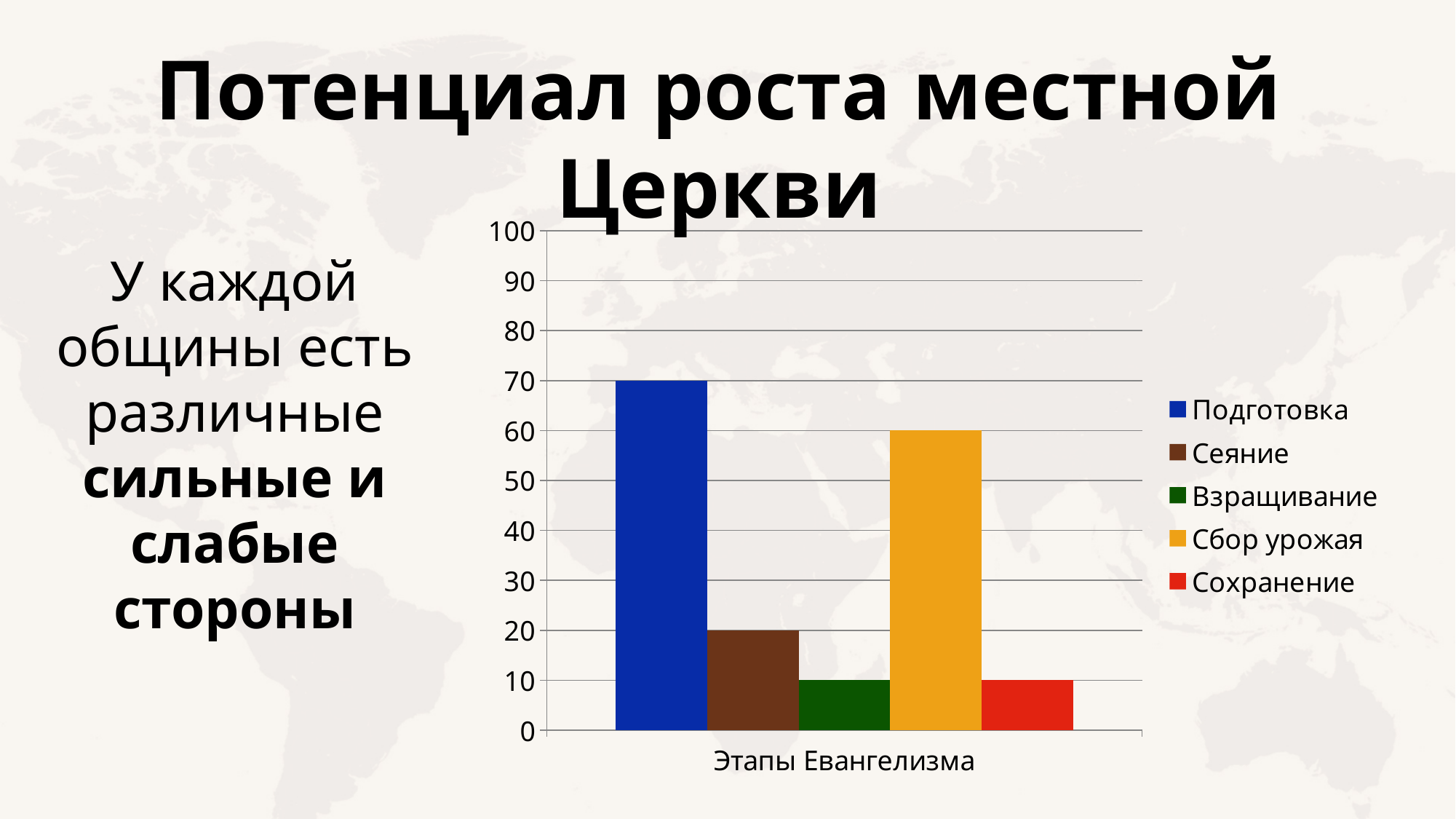
What is the difference between the values for Подготовка and Сбор урожая? 10 Which series has the highest value? Подготовка What is the value for Сбор урожая? 60 Which is larger, the value for Сеяние or the value for Сохранение? Сеяние How many series does the legend list? 5 What is the value for Подготовка? 70 What is the value for Сеяние? 20 What type of chart is shown on the slide? bar chart What colour is the bar for Сохранение? red Is the value for Сбор урожая greater or less than 50? greater What is the label on the x axis of the chart? Этапы Евангелизма What is the value for Взращивание? 10